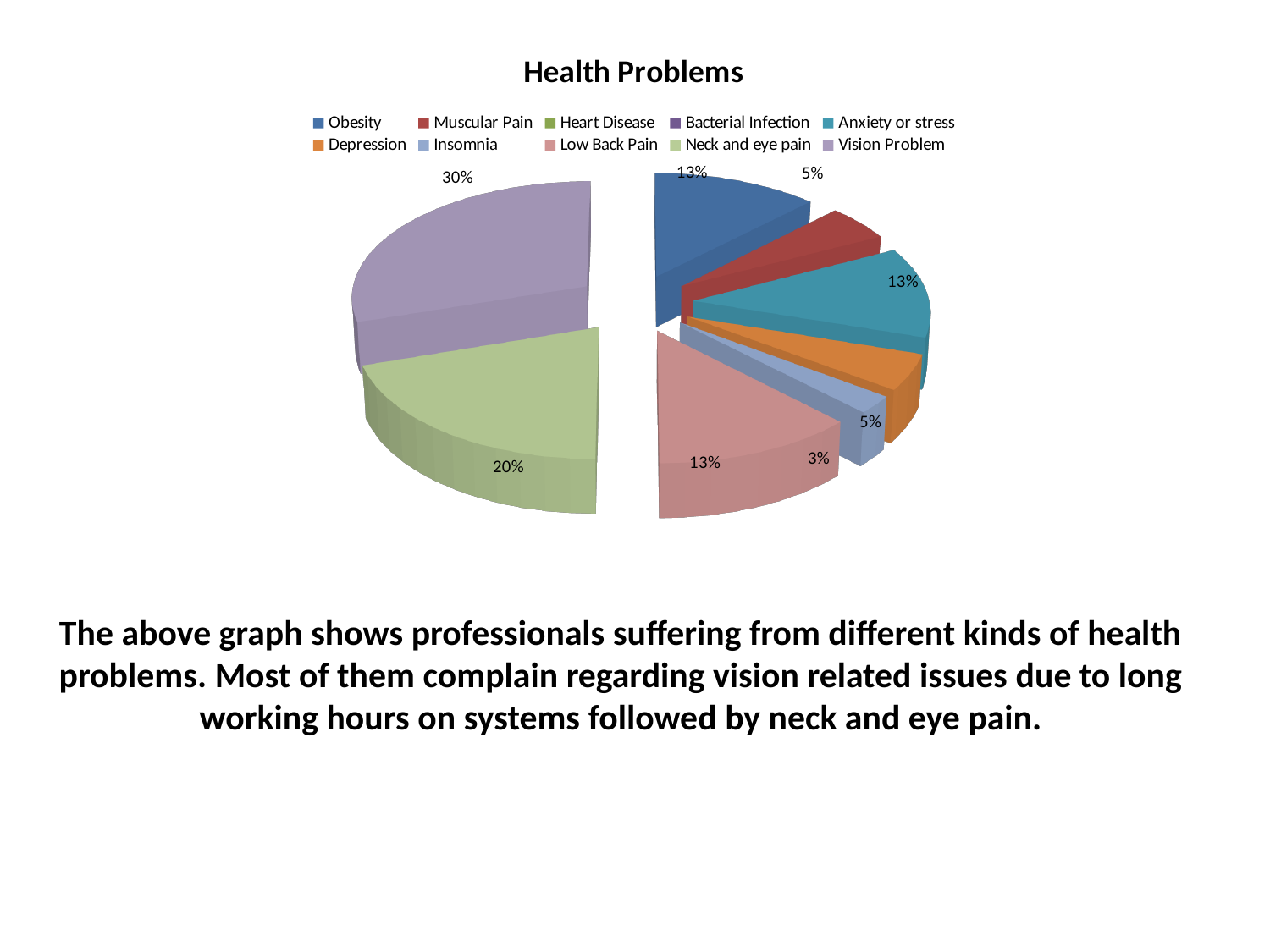
What is the value shown for Muscular Pain? 5% What is the difference between the Vision Problem share and the Neck and eye pain share? 10% Which category has the largest slice of the pie? Vision Problem What share of the pie does Vision Problem account for? 30% What is the value shown for Anxiety or stress? 13% What kind of chart is shown on the slide? Pie chart What is the value shown for Obesity? 13% What is the title of the chart? Health Problems What is the value shown for Low Back Pain? 13% Which is larger, the slice for Neck and eye pain or the slice for Low Back Pain? Neck and eye pain What is the value shown for Neck and eye pain? 20% How many categories does the legend of the chart list? 10